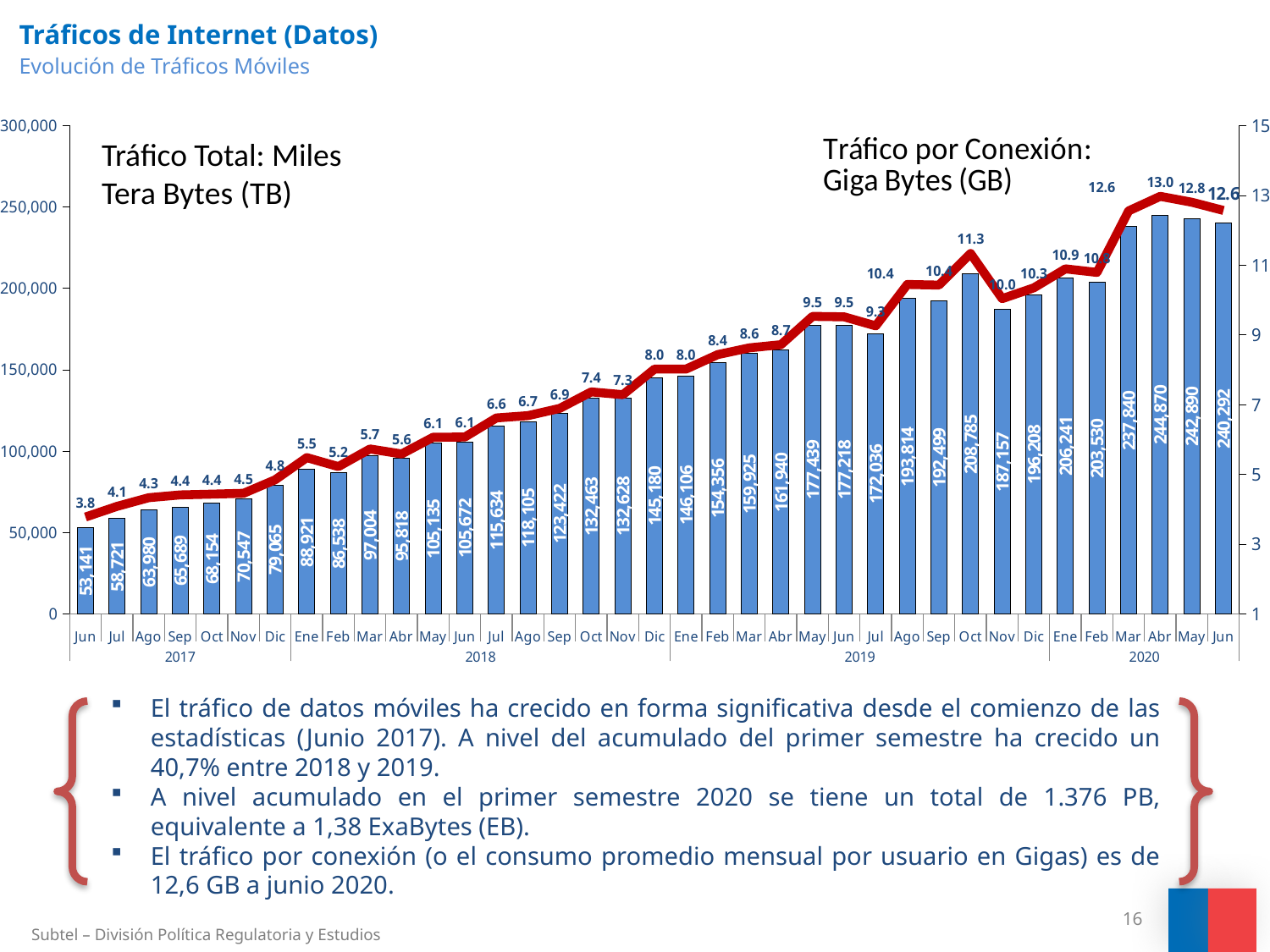
Does the traffic per connection line generally rise or fall from Jun 2017 to Jun 2020? Rise What is the highest traffic per connection value shown on the line? 13.0 Which month has the lowest total traffic bar? Jun 2017 What kind of chart is used to show the total traffic values? Bar chart How many monthly bars are plotted in the chart? 37 Which month has the highest total traffic bar? Abr 2020 What is the total mobile traffic (miles TB) shown for Jun 2020? 240,292 Is the total traffic bar for Mar 2020 greater or less than 200,000? greater What is the total mobile traffic (miles TB) shown for Jun 2017? 53,141 What is the traffic per connection (GB) shown for Jun 2020? 12.6 What is the difference in total traffic between Jun 2020 and Jun 2017? 187,151 Which month has a larger total traffic bar, Oct 2019 or Nov 2019? Oct 2019